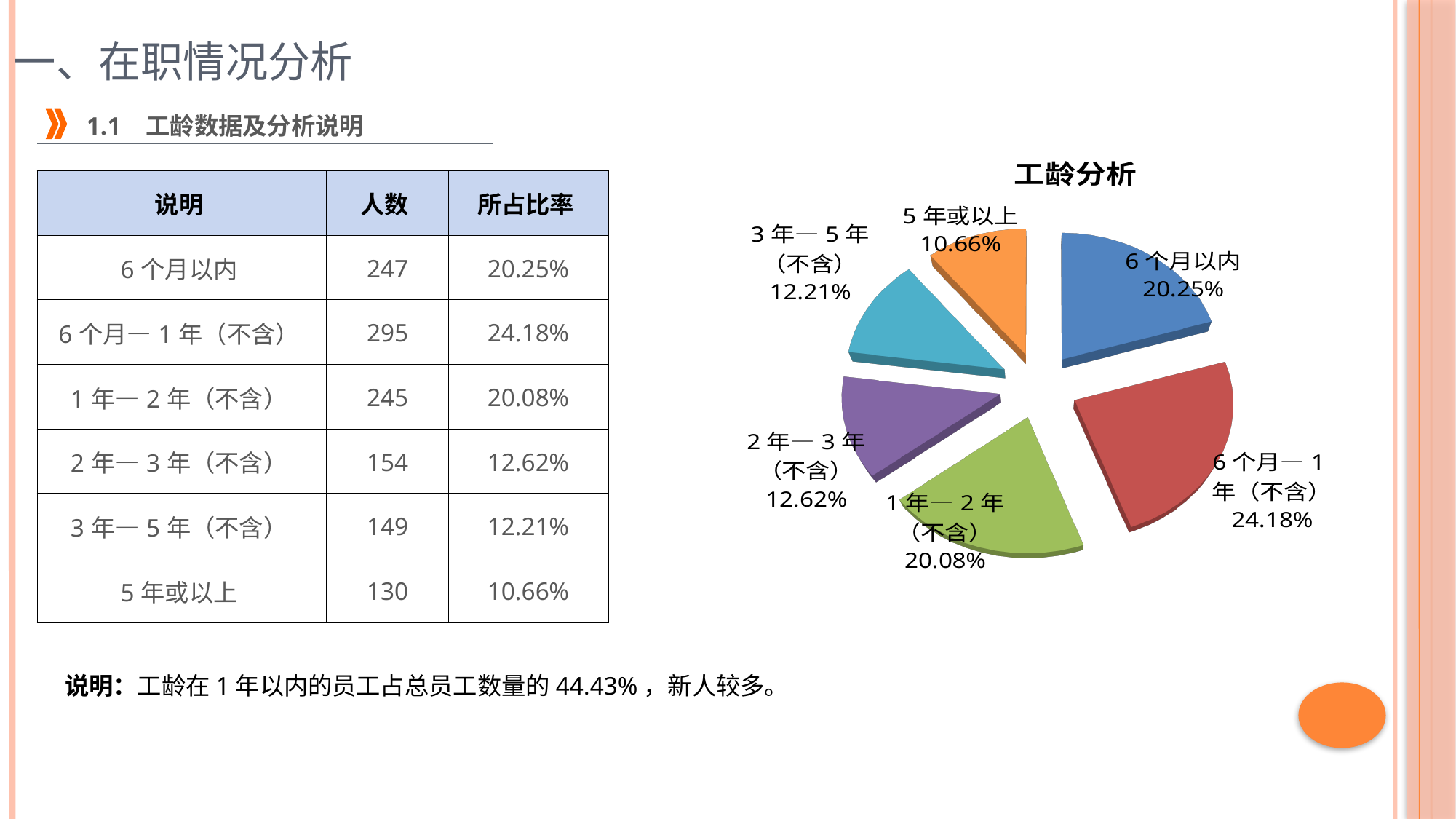
Which is larger: the share for 2年—3年（不含） or the share for 3年—5年（不含）? 2年—3年（不含） What percentage is shown for the 3年—5年（不含） slice? 12.21% Which category has the largest share of the pie? 6个月—1年（不含） Which category has the smallest share of the pie? 5年或以上 What colour is the 6个月—1年（不含） slice? red How many slices does the pie chart have? 6 What is the difference in percentage between the 6个月以内 slice and the 1年—2年（不含） slice? 0.17% What is the title of the chart? 工龄分析 What type of chart is shown on the slide? pie chart What share of the pie does the 6个月以内 slice represent? 20.25% What percentage is shown for the 5年或以上 slice? 10.66% What is the difference in percentage between the 6个月—1年（不含） slice and the 5年或以上 slice? 13.52%